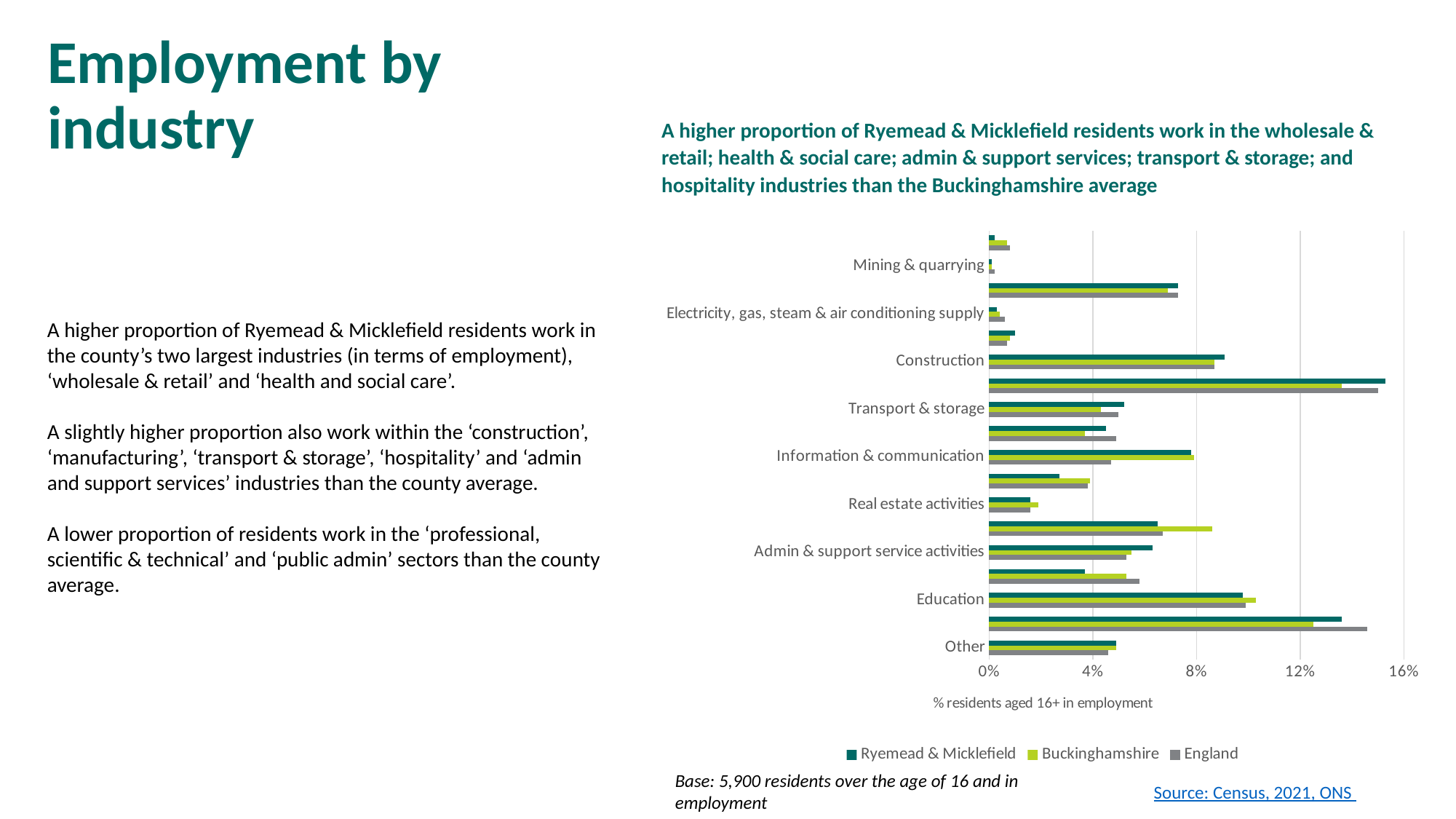
Which series are listed in the chart legend? Ryemead & Micklefield, Buckinghamshire, England How many series does the chart legend list? 3 For Information & communication, which is larger: the Ryemead & Micklefield value or the England value? Ryemead & Micklefield What is the x-axis title of the chart? % residents aged 16+ in employment Is the Ryemead & Micklefield value for Education greater or less than 8%? greater Among the labelled industries, which has the lowest Ryemead & Micklefield value? Mining & quarrying Is the Ryemead & Micklefield value for Construction greater or less than 8%? greater Is the Ryemead & Micklefield value for Real estate activities greater or less than 4%? less What kind of chart is shown on the slide? Bar chart For Transport & storage, which is larger: the Ryemead & Micklefield value or the Buckinghamshire value? Ryemead & Micklefield